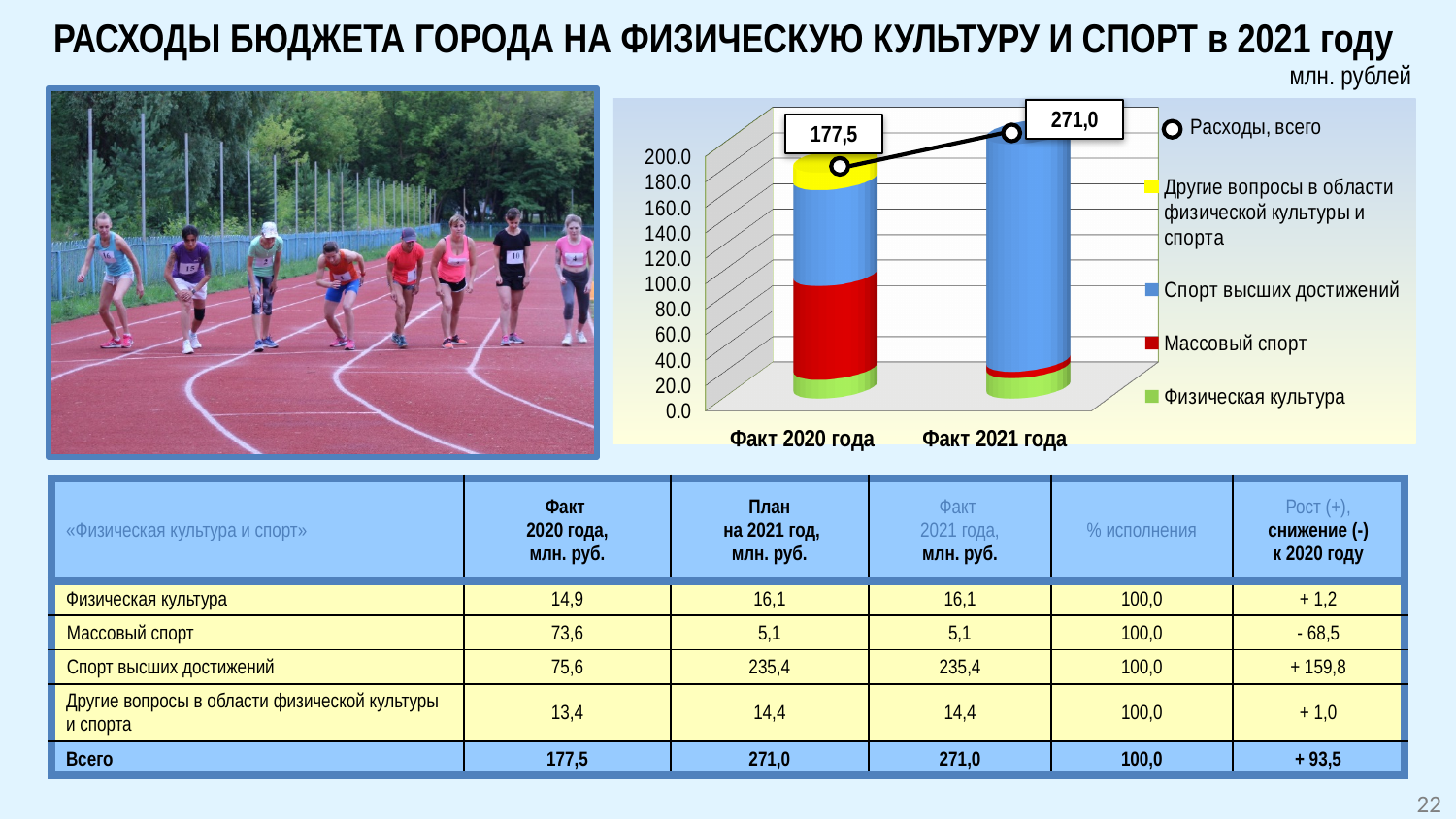
What is the value of «Расходы, всего» for «Факт 2020 года»? 177,5 Does «Расходы, всего» rise or fall from «Факт 2020 года» to «Факт 2021 года»? Rise How many series does the chart legend list? 5 Is the «Спорт высших достижений» segment for «Факт 2021 года» greater or less than 200? greater What kind of chart is shown on the slide? Stacked bar chart with a line What colour represents «Массовый спорт» in the chart? Red Which is larger, «Расходы, всего» for «Факт 2020 года» or for «Факт 2021 года»? Факт 2021 года In what units are the chart values given? млн. рублей What is the value of «Расходы, всего» for «Факт 2021 года»? 271,0 By how much does «Расходы, всего» for «Факт 2021 года» exceed «Факт 2020 года»? 93,5 How many categories are shown on the x axis of the chart? 2 Which category has the highest total expenditure? Факт 2021 года